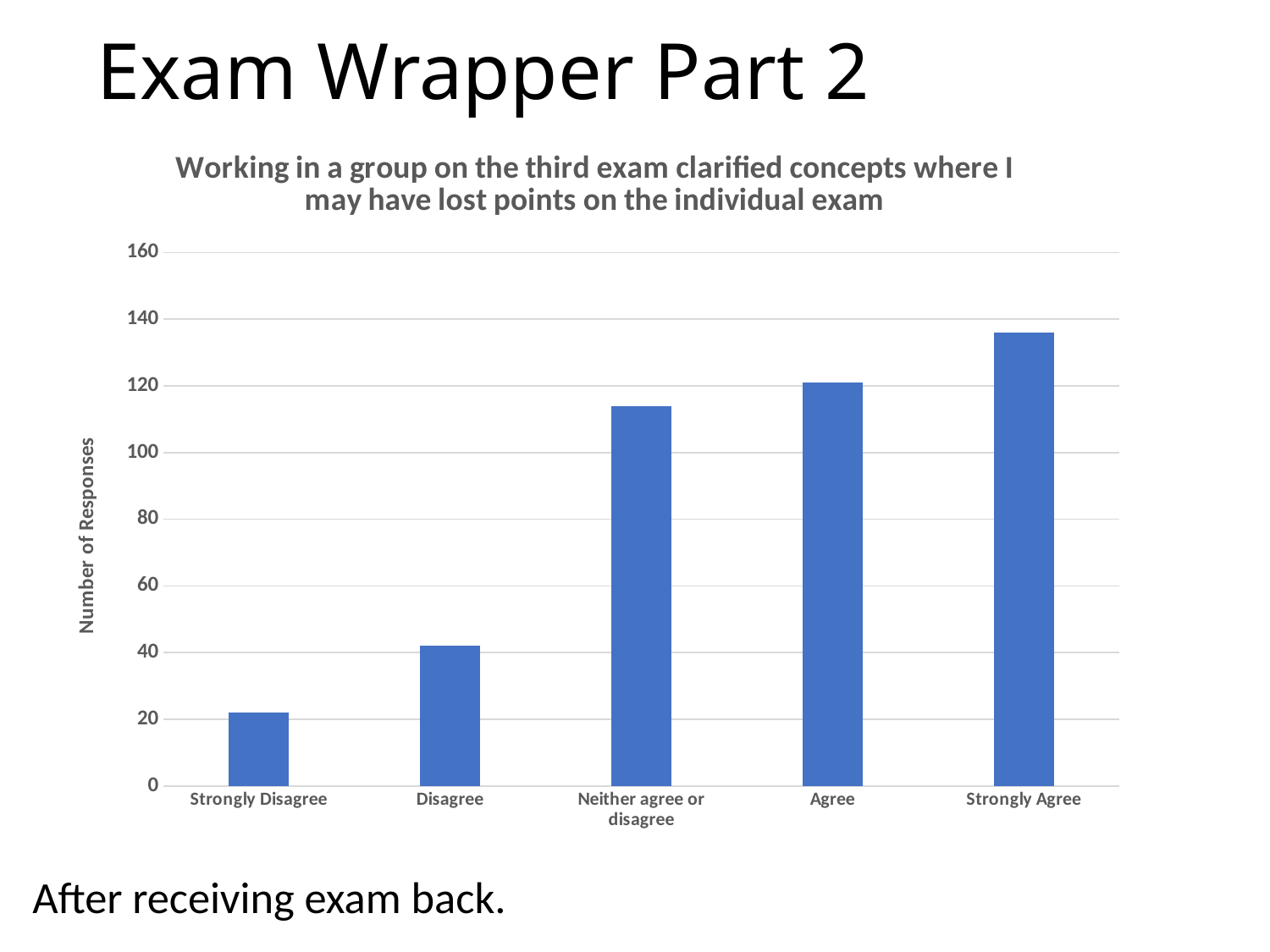
What kind of chart is shown on the slide? bar chart Is the number of responses for Strongly Disagree greater or less than 40? less Is the number of responses for Neither agree or disagree greater or less than 100? greater Which has more responses, Disagree or Strongly Disagree? Disagree Which has more responses, Agree or Strongly Agree? Strongly Agree Which response category has the lowest number of responses? Strongly Disagree How many response categories are shown on the x axis? 5 What is the label of the vertical axis? Number of Responses Is the number of responses for Strongly Agree greater or less than 120? greater Do the number of responses rise or fall moving from Strongly Disagree to Strongly Agree along the x axis? rise Which response category has the highest number of responses? Strongly Agree